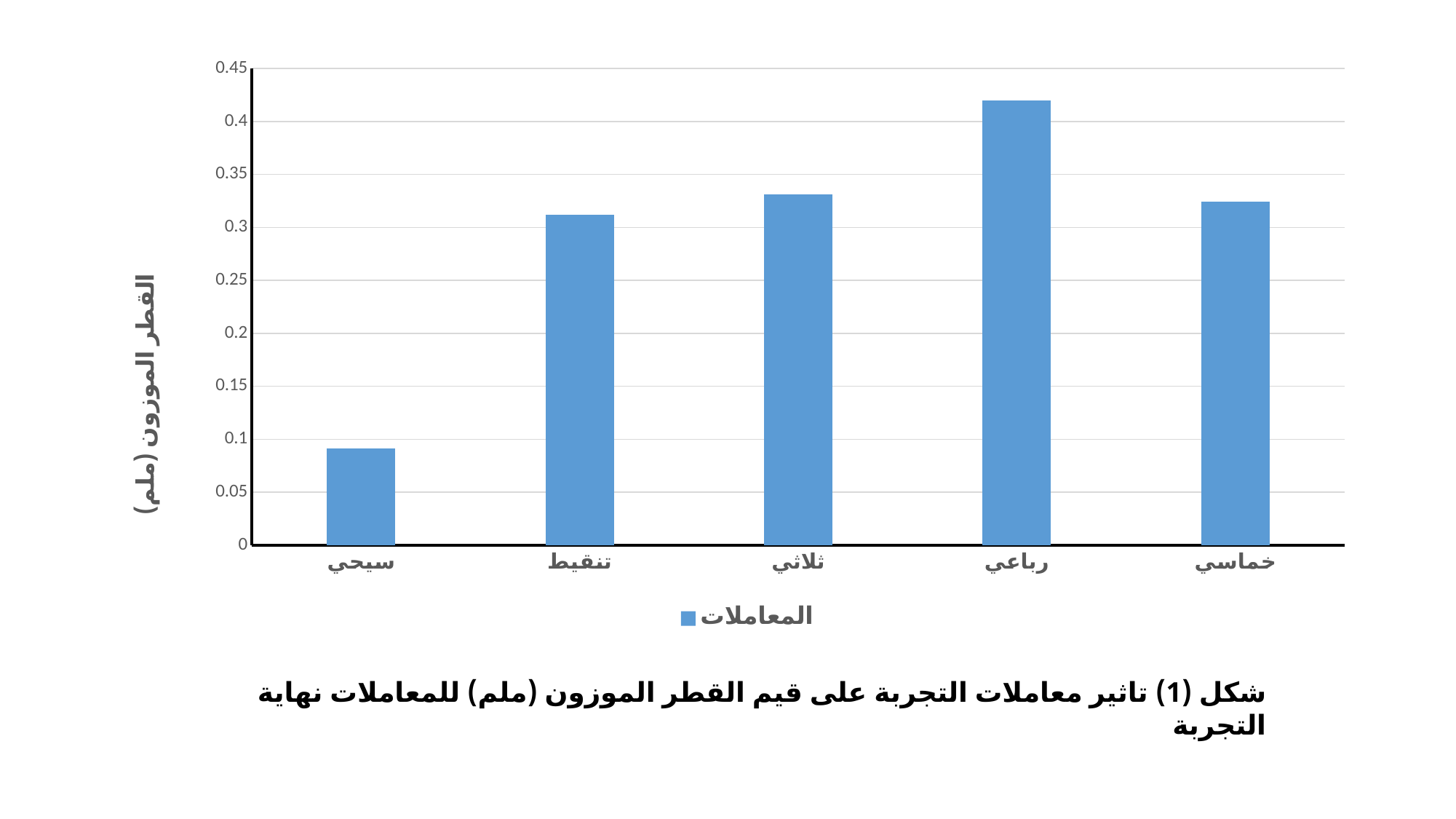
Is the value for خماسي greater or less than 0.35? less What is the title of the vertical axis? القطر الموزون (ملم) Which is larger, the value for رباعي or the value for خماسي? رباعي Is the value for تنقيط greater or less than 0.3? greater How many series does the legend list? 1 Which category has the lowest bar? سيحي What kind of chart is shown on the slide? bar chart Is the value for رباعي greater or less than 0.4? greater How many categories are plotted on the x axis? 5 What is the legend entry shown below the chart? المعاملات Which category has the highest bar? رباعي